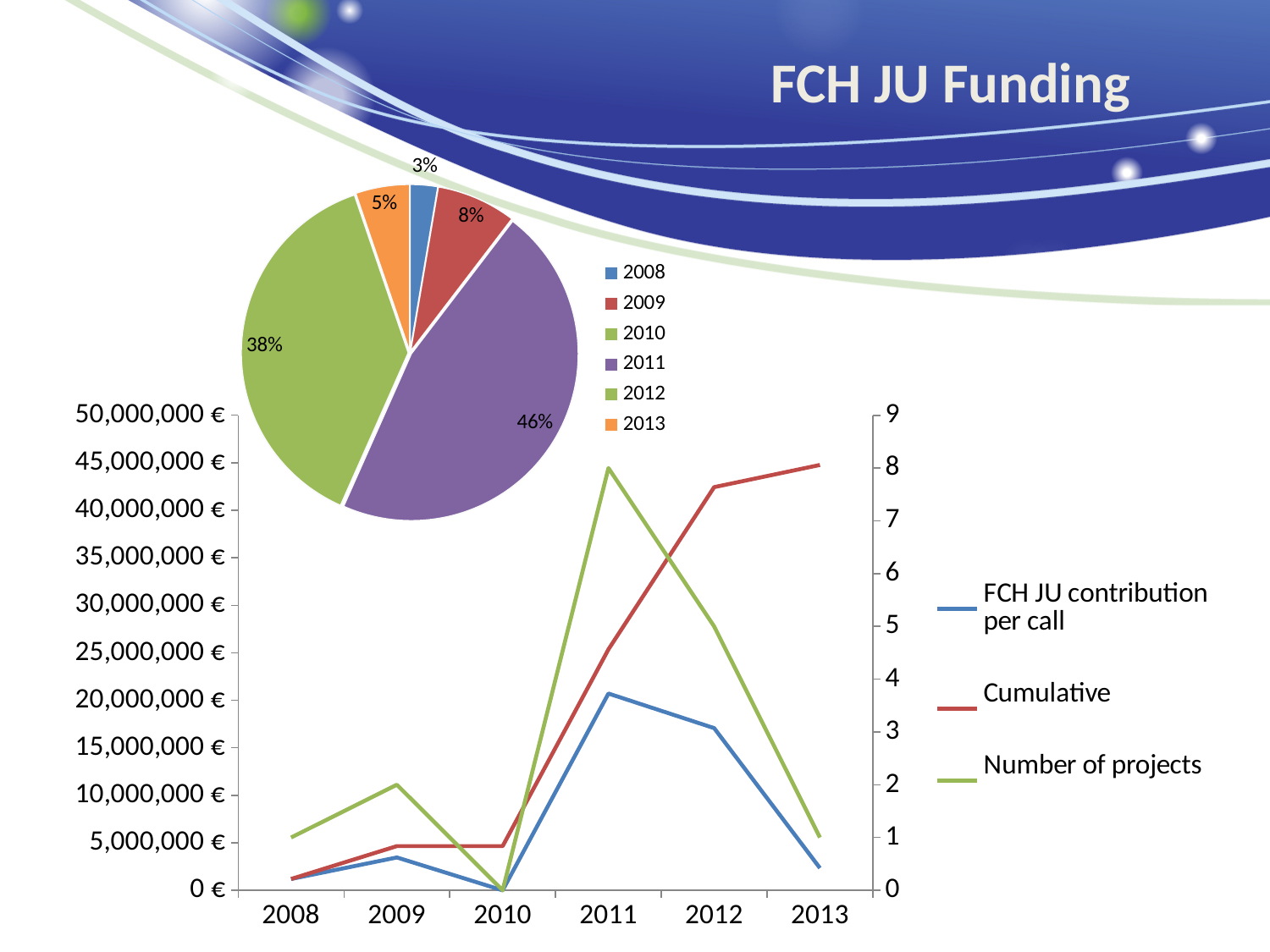
On the line chart, does the Cumulative series rise or fall from 2010 to 2013? Rise On the line chart, is the Cumulative value for 2013 greater or less than 40,000,000 €? greater On the line chart, how many years are shown on the x axis? 6 On the line chart, what is the Number of projects in 2011? 8 On the pie chart, which is larger, the slice for 2008 or the slice for 2013? 2013 On the line chart, how many series does the legend list? 3 What kind of chart is the chart at the bottom of the slide? Line chart On the pie chart, how many years does the legend list? 6 On the pie chart, what share does 2012 have? 38% On the pie chart, which year has the largest slice? 2011 On the pie chart, what share does 2011 have? 46% On the pie chart, what share does 2009 have? 8%